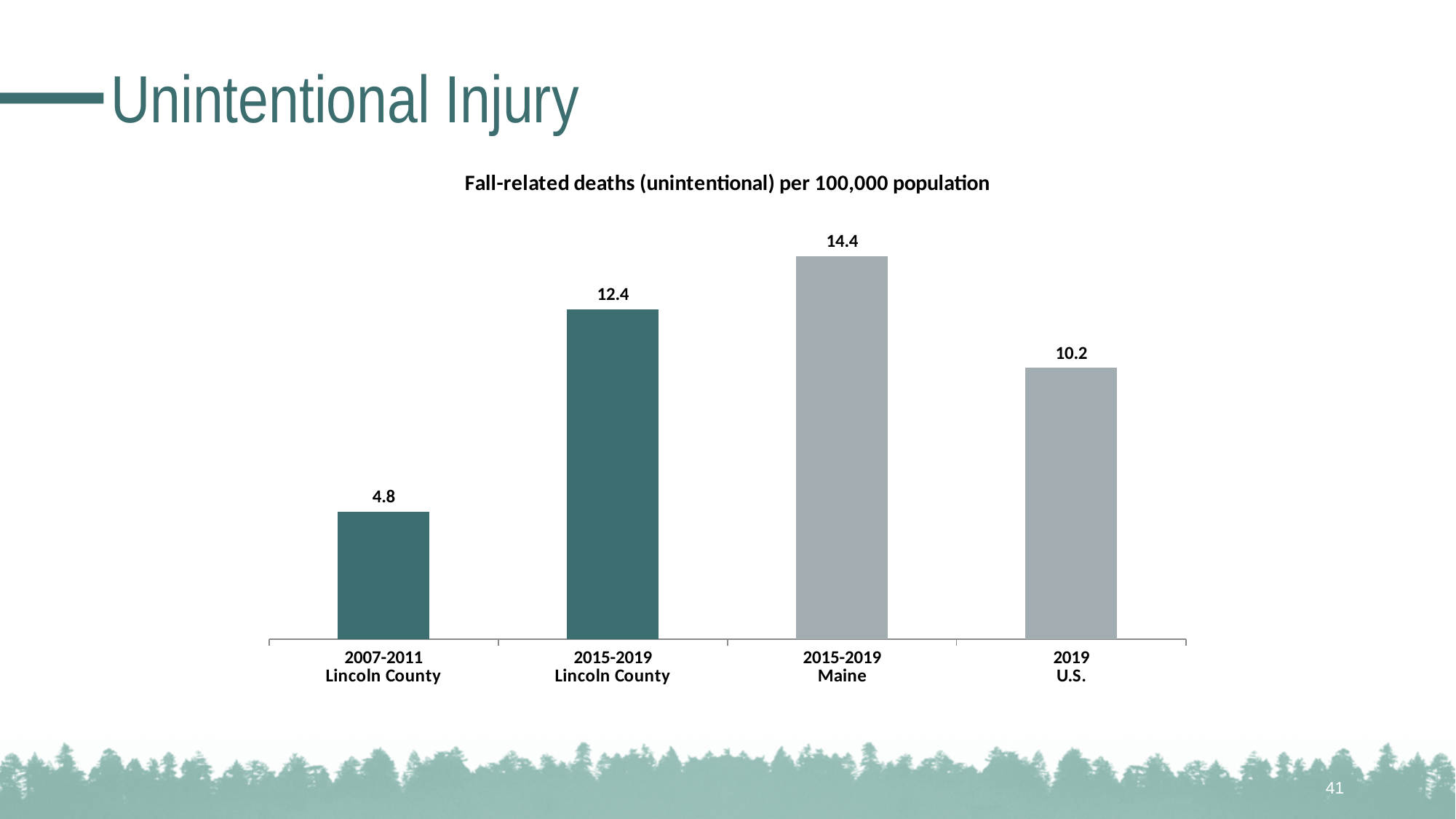
What is the value for 2015-2019 Maine? 14.4 What is the difference between the values for 2015-2019 Lincoln County and 2007-2011 Lincoln County? 7.6 Which category has the highest value? 2015-2019 Maine What kind of chart is shown on the slide? Bar chart What is the value for 2019 U.S.? 10.2 What is the value for 2007-2011 Lincoln County? 4.8 What is the difference between the values for 2015-2019 Maine and 2019 U.S.? 4.2 What is the value for 2015-2019 Lincoln County? 12.4 How many categories are shown in the chart? 4 Which category has the lowest value? 2007-2011 Lincoln County Which is larger, the value for 2015-2019 Lincoln County or the value for 2019 U.S.? 2015-2019 Lincoln County What is the title of the chart? Fall-related deaths (unintentional) per 100,000 population